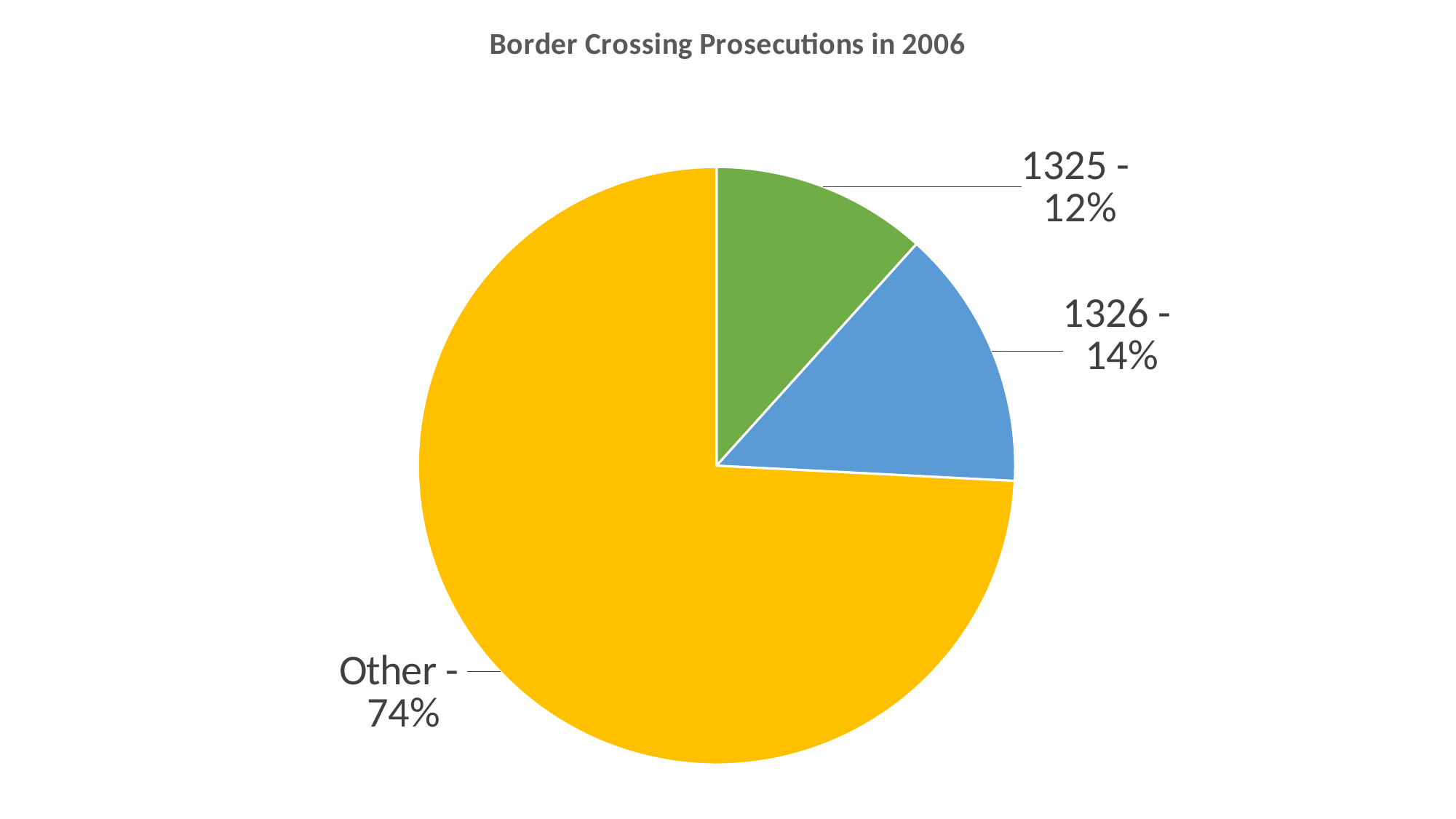
What share of the pie does the '1325' slice represent? 12% What share of the pie does the 'Other' slice represent? 74% Which is larger, the '1325' slice or the '1326' slice? 1326 What is the difference in percentage points between the '1326' slice and the '1325' slice? 2% What share of the pie does the '1326' slice represent? 14% Which slice is the largest? Other How many slices does the pie chart have? 3 What is the title of the chart? Border Crossing Prosecutions in 2006 Which slice is the smallest? 1325 What kind of chart is shown on the slide? pie chart What colour is the 'Other' slice? yellow What is the difference in percentage points between the 'Other' slice and the '1326' slice? 60%